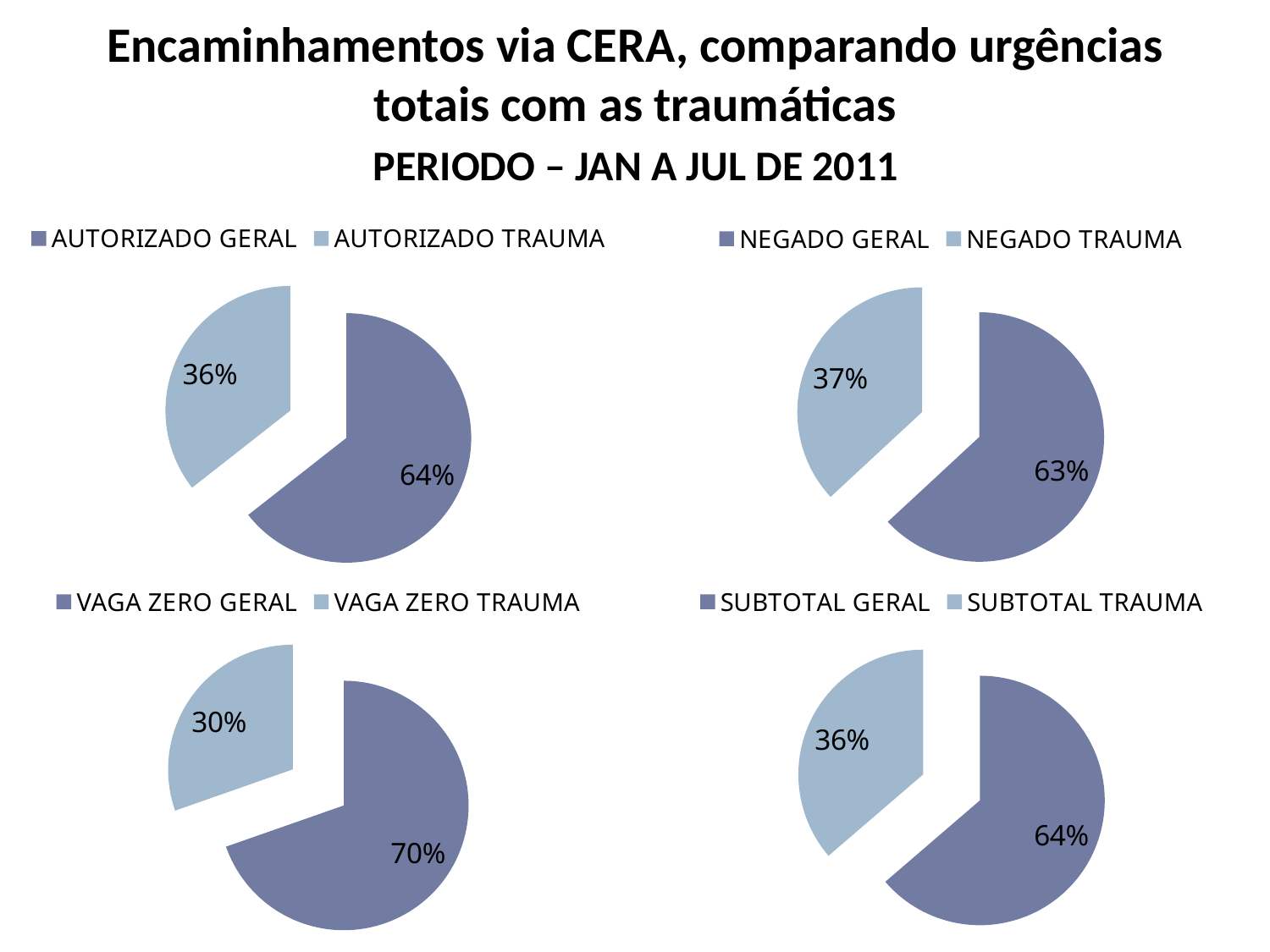
In the bottom-left pie chart (VAGA ZERO), what percentage is shown for VAGA ZERO TRAUMA? 30% What kind of chart is the top-right chart (NEGADO)? Pie chart How many pie charts are shown on the slide? 4 How many slices does the bottom-right pie chart (SUBTOTAL) have? 2 In the bottom-left pie chart (VAGA ZERO), which slice is larger, VAGA ZERO GERAL or VAGA ZERO TRAUMA? VAGA ZERO GERAL In the top-left pie chart (AUTORIZADO), what percentage is shown for AUTORIZADO GERAL? 64% In the bottom-left pie chart (VAGA ZERO), what is the difference in percentage points between VAGA ZERO GERAL and VAGA ZERO TRAUMA? 40 In the bottom-left pie chart (VAGA ZERO), what percentage is shown for VAGA ZERO GERAL? 70% In the top-left pie chart (AUTORIZADO), what percentage is shown for AUTORIZADO TRAUMA? 36% In the top-right pie chart (NEGADO), what percentage is shown for NEGADO GERAL? 63% In the bottom-right pie chart (SUBTOTAL), what percentage is shown for SUBTOTAL TRAUMA? 36% In the top-right pie chart (NEGADO), what percentage is shown for NEGADO TRAUMA? 37%